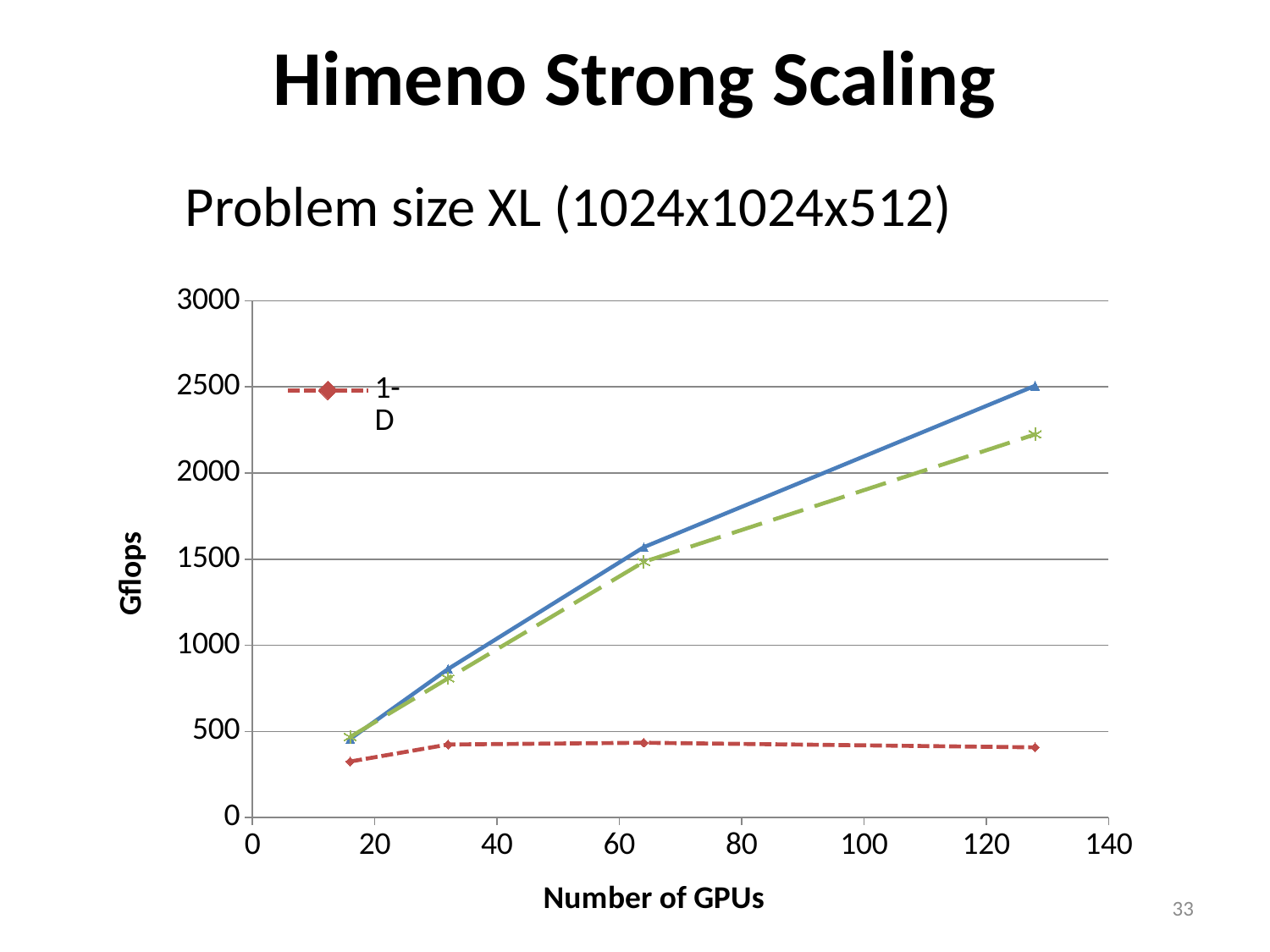
Is the value for the 1-D series at 128 GPUs greater or less than 500 Gflops? less Is the value for the 1-D series at 16 GPUs greater or less than 500 Gflops? less Is the value of the green dashed line at 32 GPUs greater or less than 1000 Gflops? less Does the solid blue line rise or fall as the number of GPUs increases? rise What kind of chart is shown on the slide? line chart Which series has the lowest value at 128 GPUs? 1-D At 128 GPUs, which is larger: the 1-D series or the solid blue line? the solid blue line How many data points does the 1-D series have? 4 What is the title of the chart's x axis? Number of GPUs What is the title of the chart's y axis? Gflops